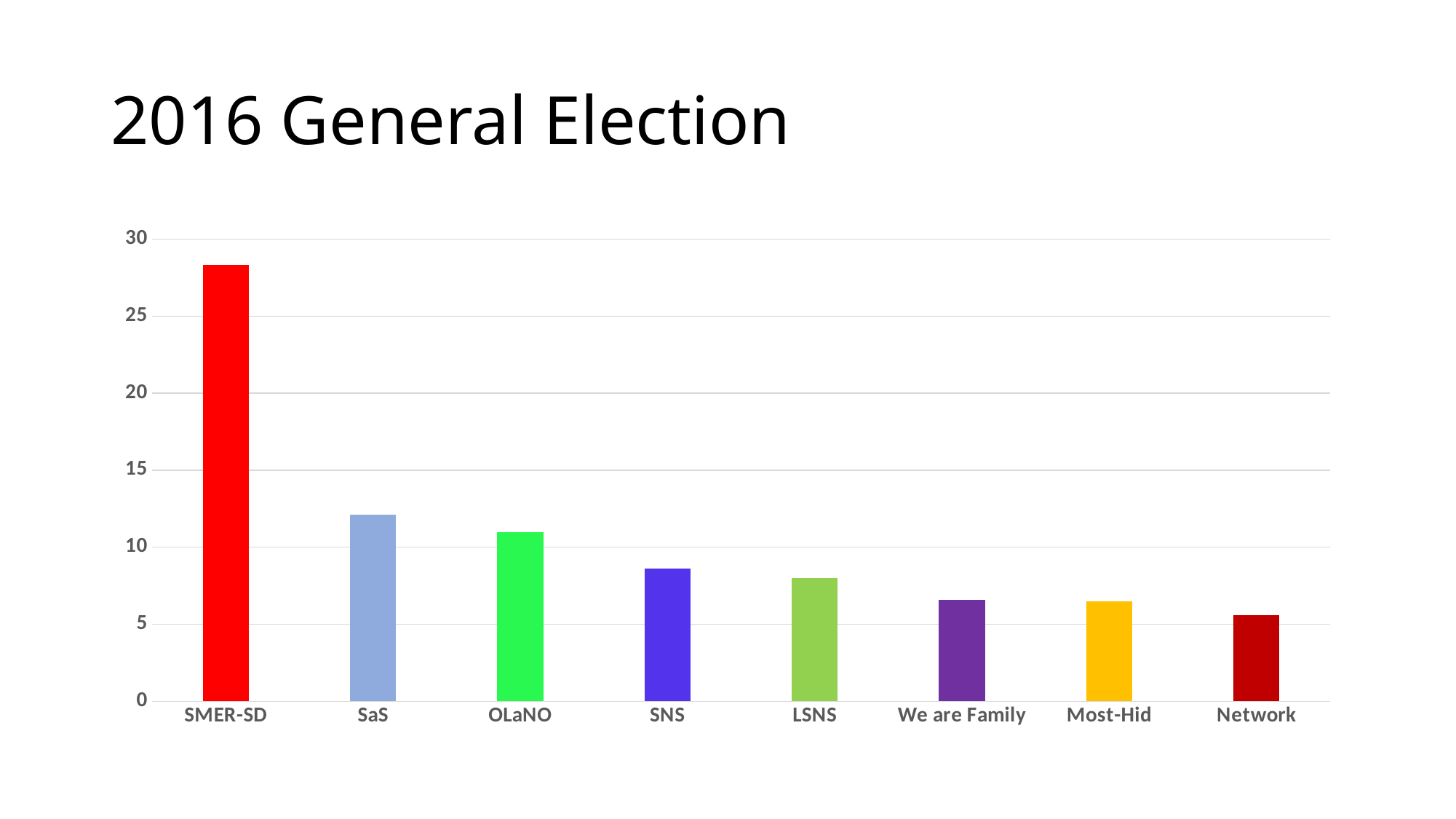
Is the value for SMER-SD greater or less than 25? greater What is the title of the slide containing the chart? 2016 General Election Which party has the lowest bar in the chart? Network Which party has the highest bar in the chart? SMER-SD Is the value for Network greater or less than 5? greater Is the value for SaS greater or less than 10? greater Which is larger, the value for SaS or the value for LSNS? SaS How many parties are shown on the x axis? 8 What type of chart is shown on the slide? bar chart Do the bar values rise or fall from left to right along the x axis? fall